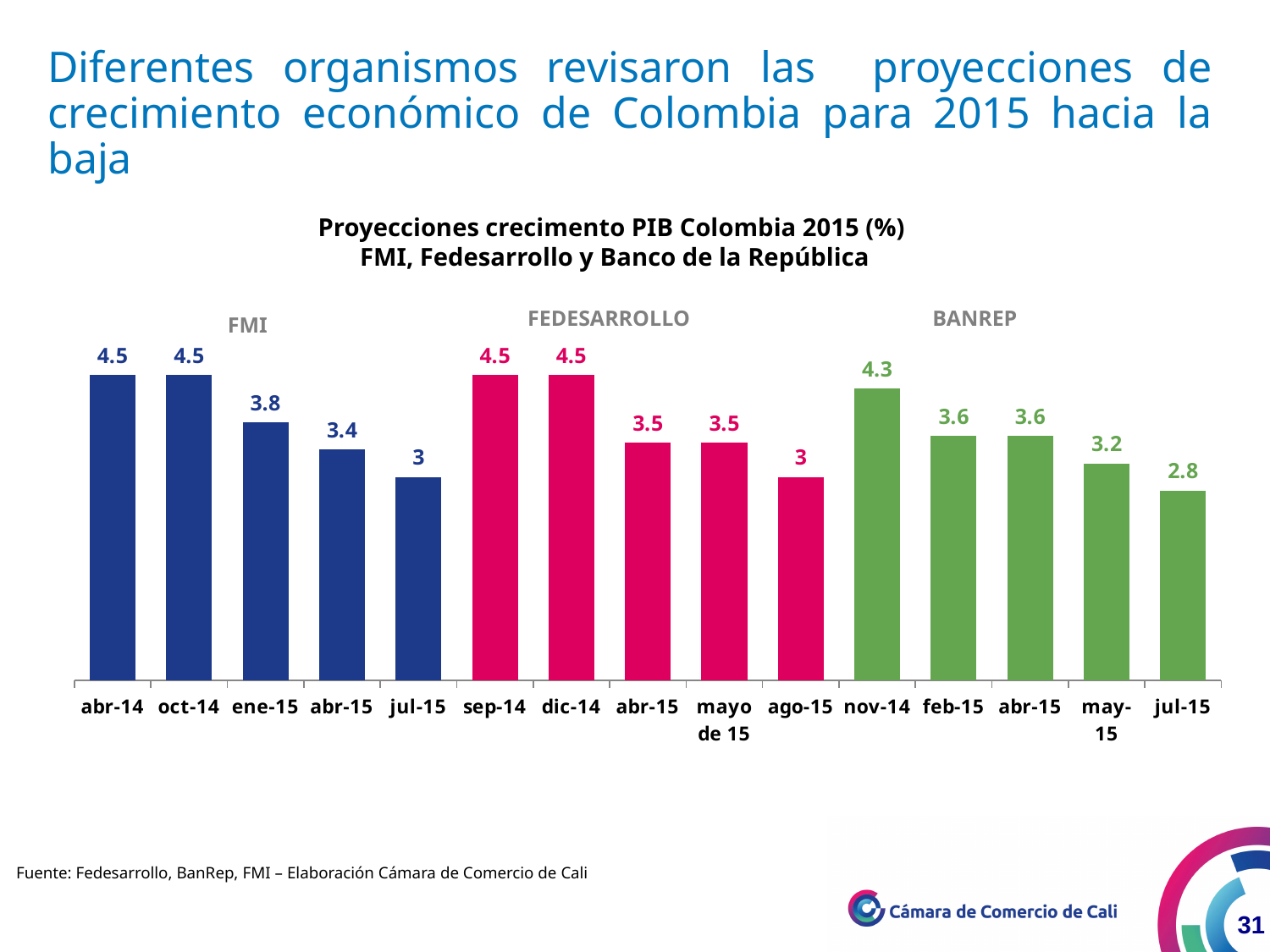
What is the difference between the FMI projection for abr-14 and the FMI projection for jul-15? 1.5 What is the difference between the BANREP projection for nov-14 and the BANREP projection for jul-15? 1.5 Which bar has the lowest value in the whole chart? BANREP jul-15 Which is larger, the FEDESARROLLO projection for abr-15 or the BANREP projection for abr-15? BANREP abr-15 Within the FMI group, do the projections rise or fall from abr-14 to jul-15? Fall Which bar in the BANREP group has the lowest value? jul-15 What is the FMI projection for jul-15? 3 What is the FMI projection for ene-15? 3.8 What is the BANREP projection for nov-14? 4.3 What kind of chart is shown on the slide? Bar chart How many bars are plotted in the chart? 15 What is the FEDESARROLLO projection for mayo de 15? 3.5